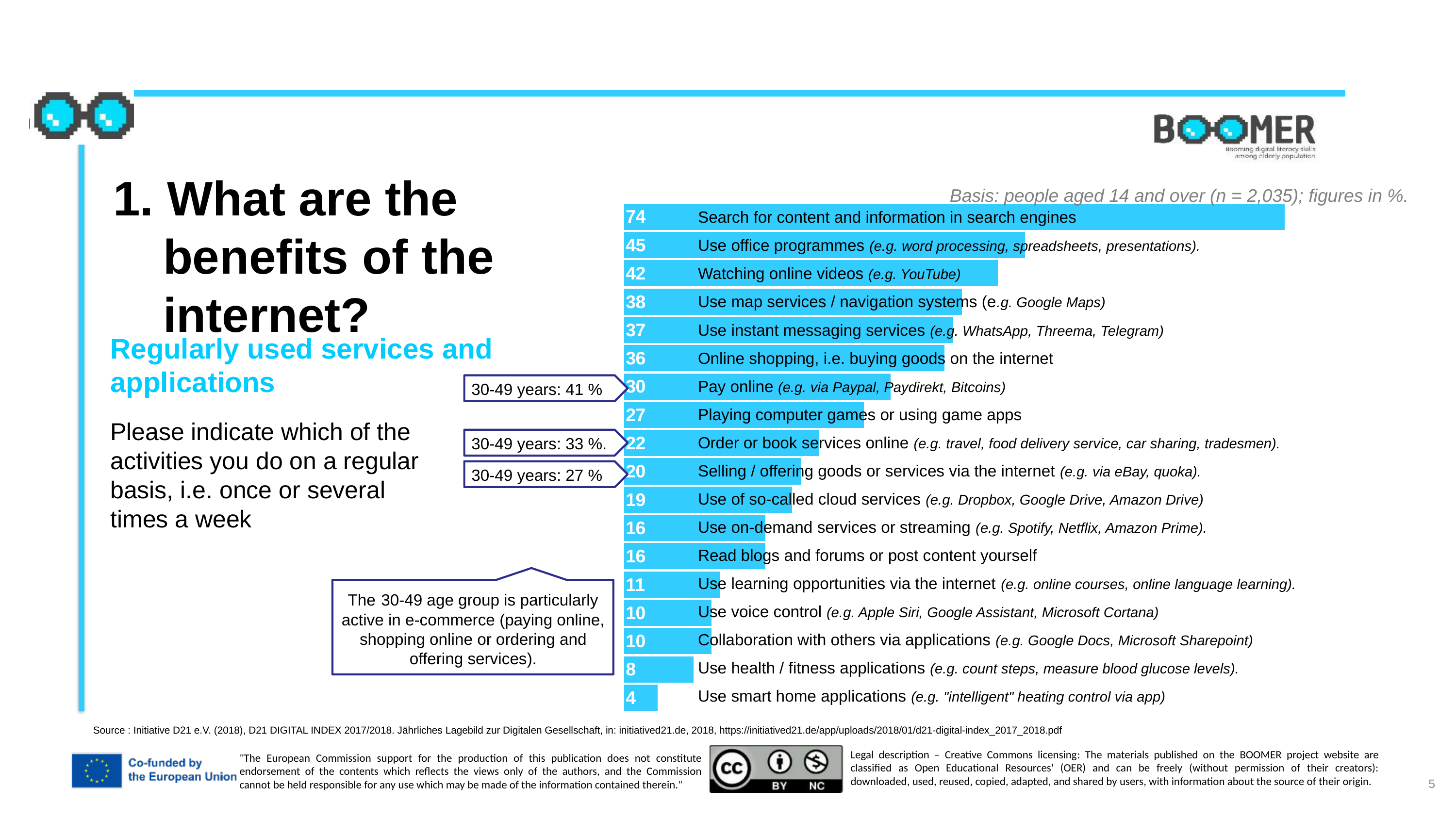
What is the value for "Search for content and information in search engines"? 74 What is the value for "Use smart home applications"? 4 How many activities are shown in the chart? 18 Which activity has the lowest value? Use smart home applications What kind of chart is shown on the slide? Bar chart What is the value for "Pay online"? 30 According to the callout, what is the value for "Pay online" among 30-49 year olds? 41 % What is the difference between the values for "Search for content and information in search engines" and "Use smart home applications"? 70 What is the value for "Watching online videos"? 42 Which has a larger value: "Online shopping" or "Playing computer games"? Online shopping What is the difference between the values for "Use office programmes" and "Watching online videos"? 3 Which activity has the highest value? Search for content and information in search engines